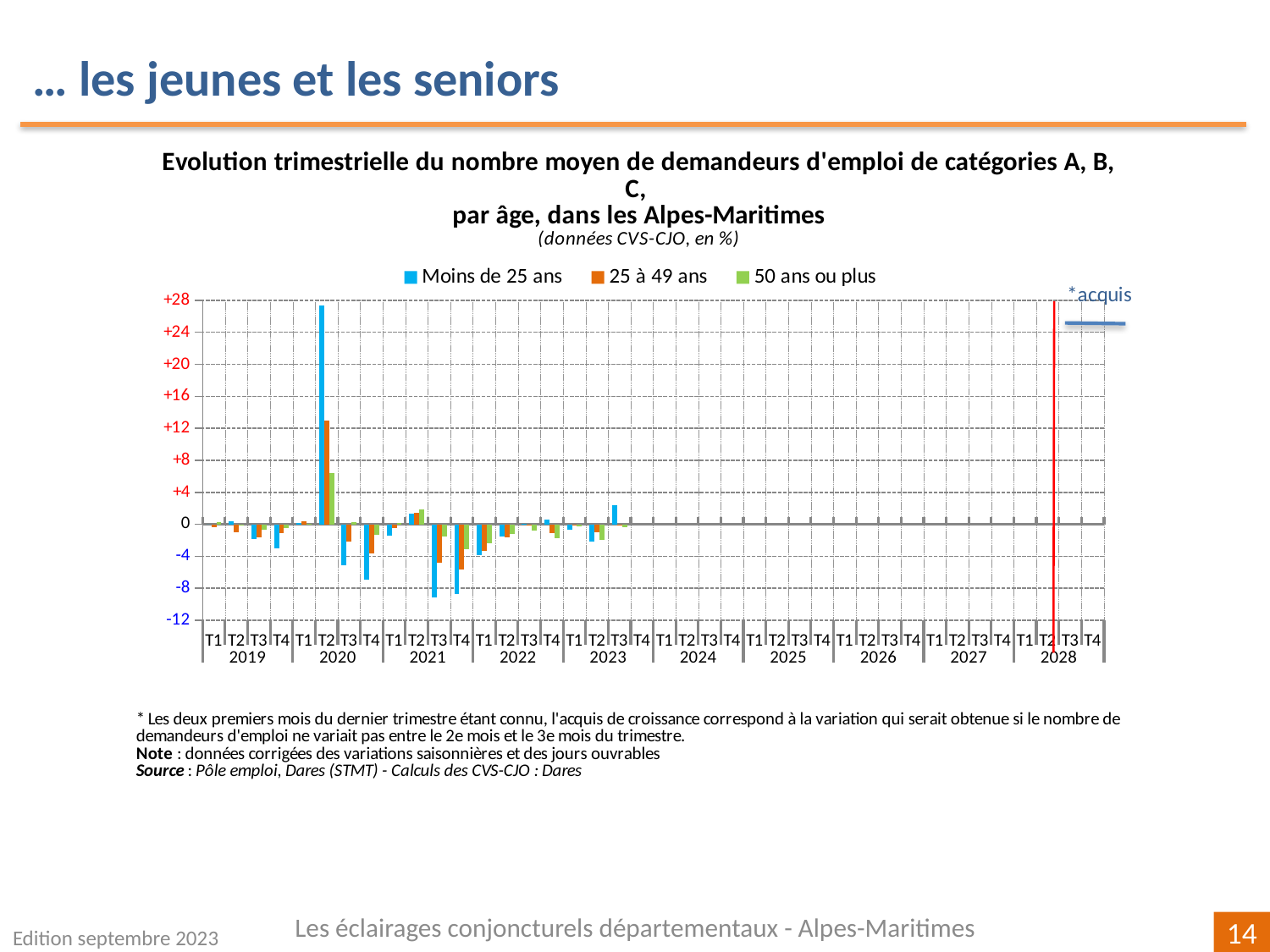
Which series has the highest value in T2 2020? Moins de 25 ans Is the value for '50 ans ou plus' in T2 2020 greater or less than +4? greater Is the value for 'Moins de 25 ans' in T2 2020 greater or less than +24? greater How many series does the legend list? 3 In which quarter does the 'Moins de 25 ans' series reach its highest value? T2 2020 Is the value for 'Moins de 25 ans' in T3 2021 greater or less than -4? less Which age groups are listed in the legend? Moins de 25 ans, 25 à 49 ans, 50 ans ou plus What is the highest tick value shown on the y axis? +28 How many years are labelled along the x axis? 10 In T2 2020, which is larger: the value for 'Moins de 25 ans' or the value for '50 ans ou plus'? Moins de 25 ans What kind of chart is shown on the slide? Bar chart